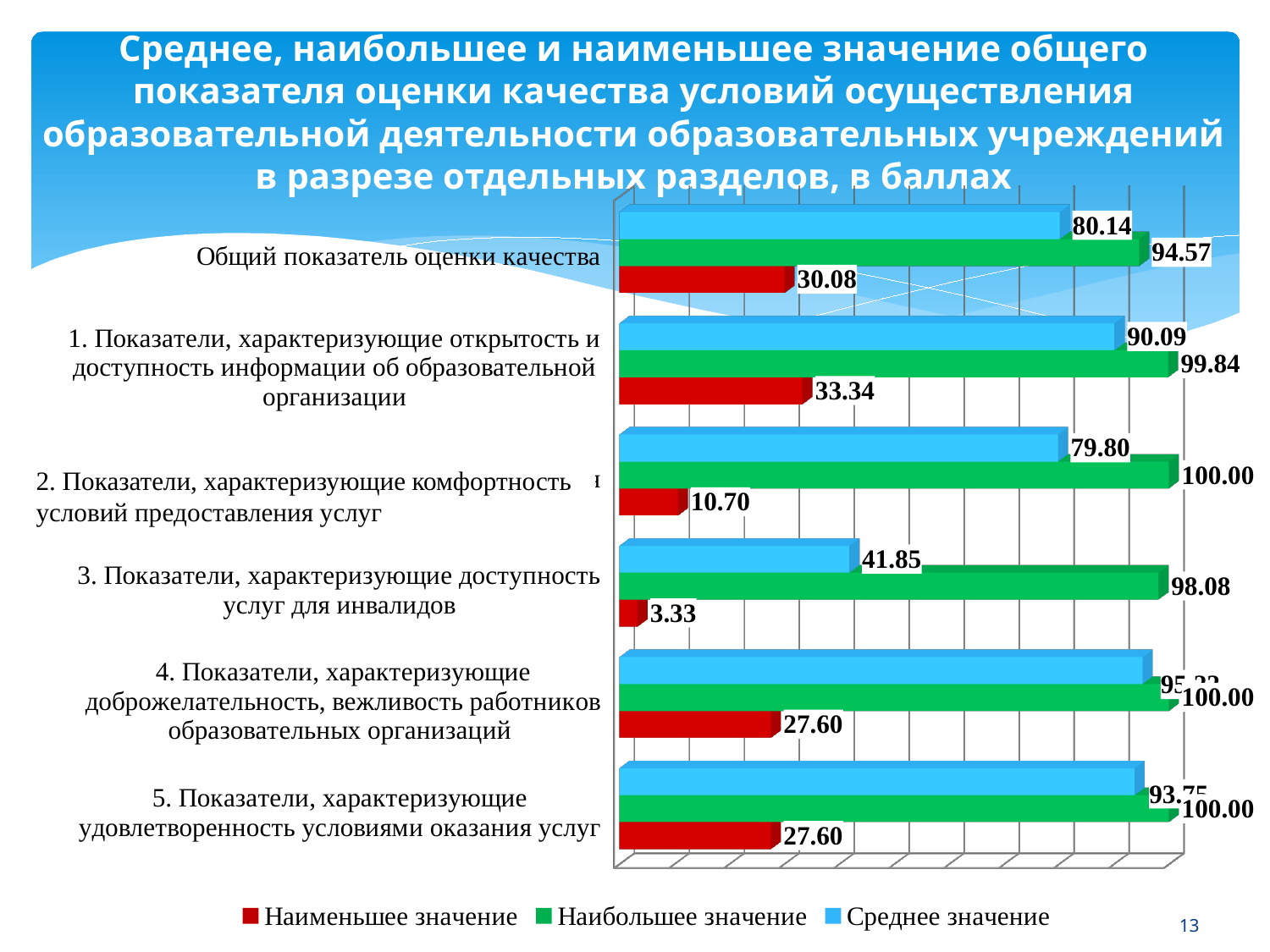
How many categories are shown on the chart? 6 Which has the larger Среднее значение: category 1 (открытость и доступность информации) or category 2 (комфортность условий предоставления услуг)? Category 1 (открытость и доступность информации) What is the Среднее значение for category 1 (Показатели, характеризующие открытость и доступность информации об образовательной организации)? 90.09 Which category has the lowest Наименьшее значение? 3. Показатели, характеризующие доступность услуг для инвалидов What is the Наибольшее значение for category 3 (Показатели, характеризующие доступность услуг для инвалидов)? 98.08 How many series does the legend list? 3 What is the Наименьшее значение for Общий показатель оценки качества? 30.08 What colour represents Наибольшее значение in the legend? Green What kind of chart is shown on the slide? Bar chart Which category has the lowest Среднее значение? 3. Показатели, характеризующие доступность услуг для инвалидов What is the difference between the Наибольшее значение and the Наименьшее значение for Общий показатель оценки качества? 64.49 What is the Наименьшее значение for category 2 (Показатели, характеризующие комфортность условий предоставления услуг)? 10.70